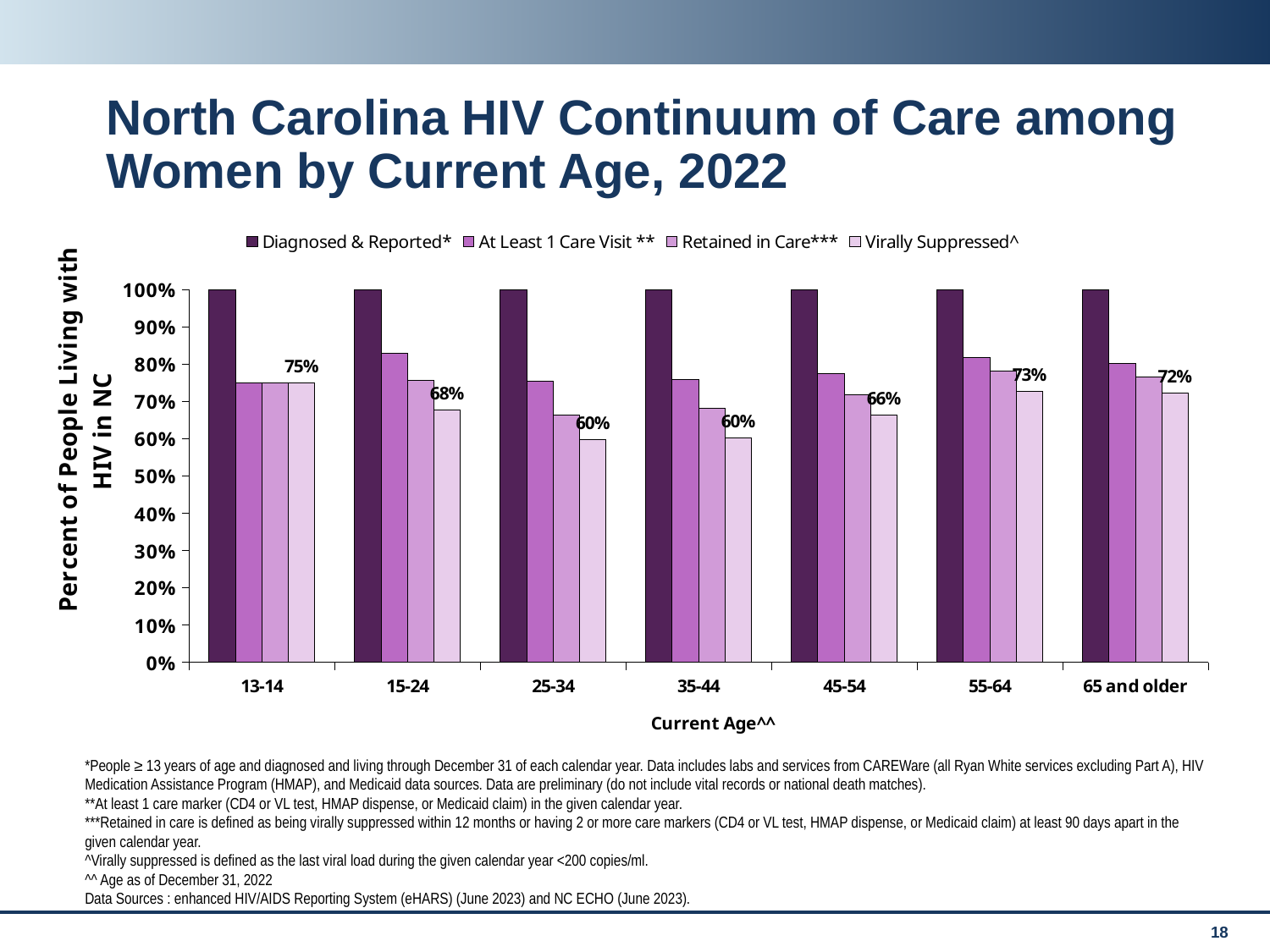
What is the Diagnosed & Reported value for the 35-44 age group? 100% What is the Virally Suppressed value for the 65 and older age group? 72% What type of chart is shown on the slide? bar chart How many series does the legend list? 4 How many age groups are shown on the x axis? 7 What is the Virally Suppressed value for the 13-14 age group? 75% What is the difference between the Virally Suppressed values for the 55-64 and 25-34 age groups? 13% What is the Virally Suppressed value for the 45-54 age group? 66% Which is larger, the Virally Suppressed value for 15-24 or for 45-54? 15-24 Is the At Least 1 Care Visit value for the 15-24 age group greater or less than 80%? greater Which age group has the highest Virally Suppressed value? 13-14 What is the Virally Suppressed value for the 15-24 age group? 68%